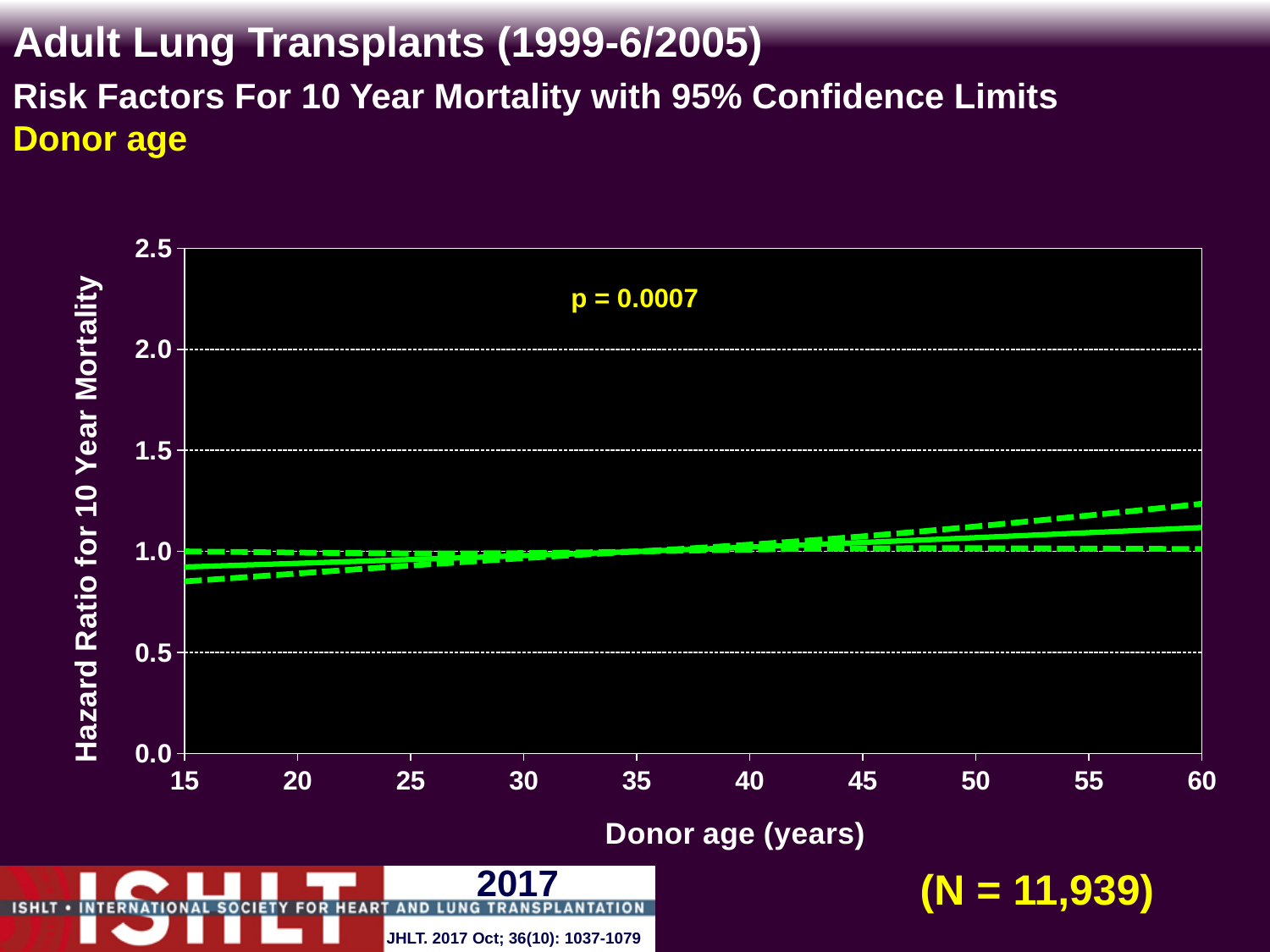
Is the upper 95% confidence limit at a donor age of 60 years greater or less than 1.5? less What is the highest value shown on the y axis? 2.5 What is the sample size (N) shown on the slide? N = 11,939 What is the p-value shown on the chart? p = 0.0007 Is the lower 95% confidence limit at a donor age of 15 years greater or less than 0.5? greater Does the hazard ratio for 10 year mortality rise or fall as donor age increases from 15 to 60 years? rise How many lines are plotted on the chart? 3 Is the hazard ratio (solid line) at a donor age of 60 years greater or less than 1.0? greater What is the label of the y axis? Hazard Ratio for 10 Year Mortality What is the label of the x axis? Donor age (years) What kind of chart is shown on the slide? line chart